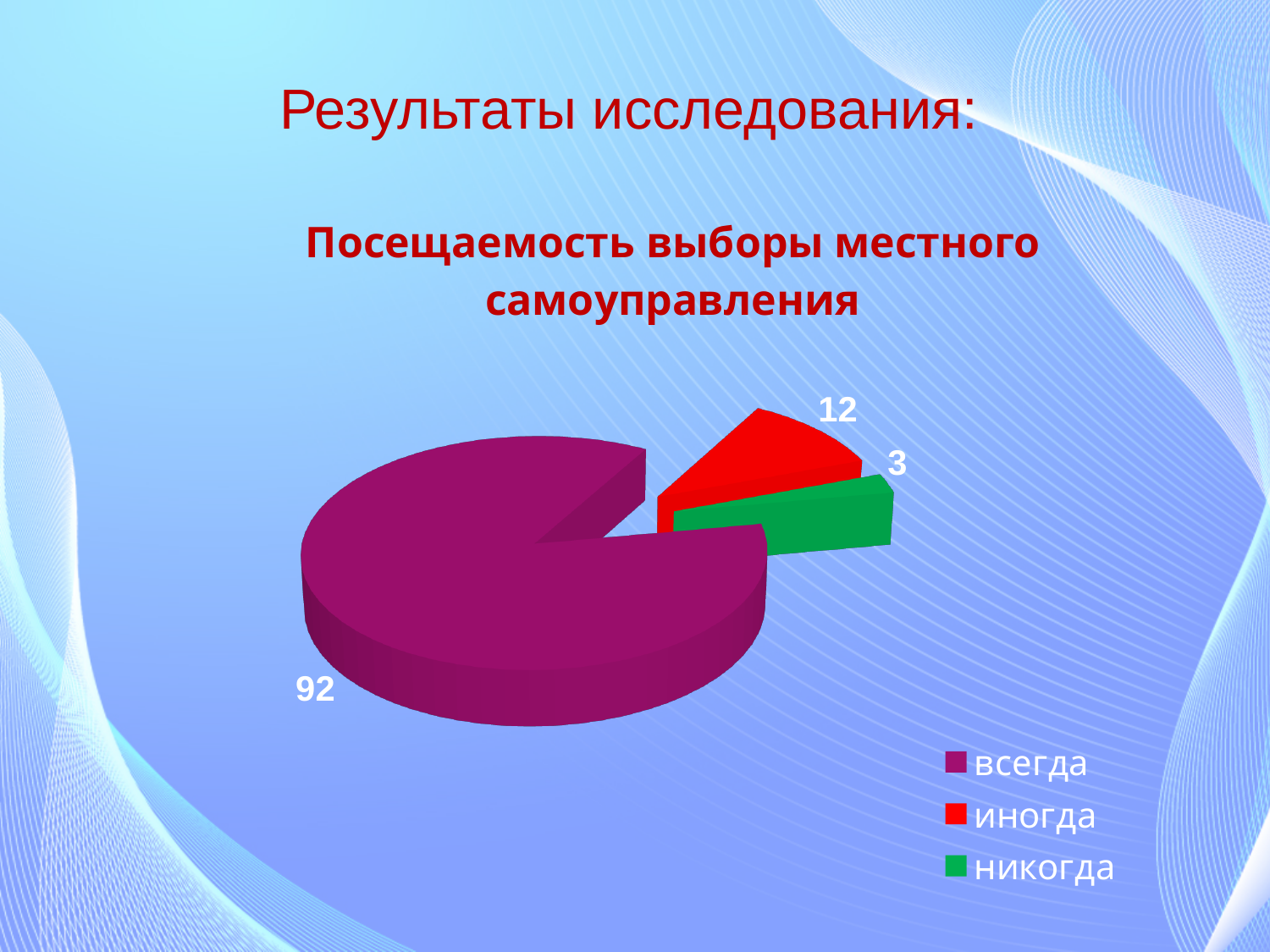
What is the value for the "всегда" slice? 92 What is the difference between the values for "иногда" and "никогда"? 9 What colour is the "никогда" slice? Green What is the value for the "никогда" slice? 3 What is the value for the "иногда" slice? 12 What kind of chart is shown on the slide? Pie chart What is the difference between the values for "всегда" and "иногда"? 80 What is the title of the chart? Посещаемость выборы местного самоуправления How many categories does the pie chart have? 3 Which category has the smallest slice of the pie? никогда Which category has the largest slice of the pie? всегда Which is larger, the value for "иногда" or the value for "никогда"? иногда